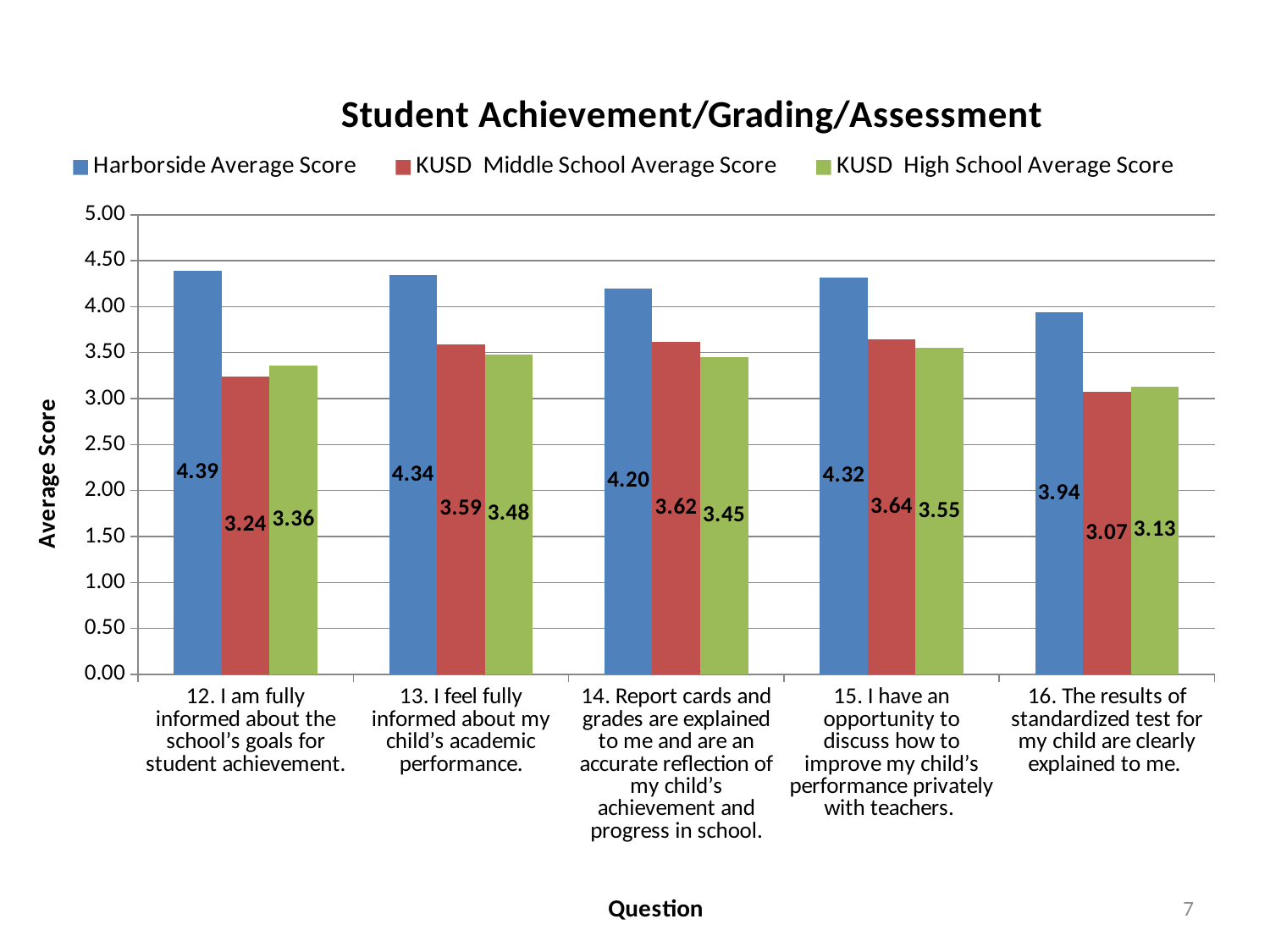
What is the title of the chart? Student Achievement/Grading/Assessment What is the KUSD Middle School Average Score for question 16 (The results of standardized test for my child are clearly explained to me)? 3.07 How many questions (categories) are shown on the x axis? 5 What is the difference between the Harborside Average Score and the KUSD Middle School Average Score for question 12? 1.15 What kind of chart is shown on the slide? Bar chart How many series does the legend list? 3 Which question has the highest Harborside Average Score? 12. I am fully informed about the school's goals for student achievement. For question 15, which is larger: the KUSD Middle School Average Score or the KUSD High School Average Score? KUSD Middle School Average Score Which question has the lowest KUSD Middle School Average Score? 16. The results of standardized test for my child are clearly explained to me. What is the KUSD High School Average Score for question 14 (Report cards and grades are explained to me)? 3.45 Is the Harborside Average Score for question 16 greater or less than 4.00? less What is the Harborside Average Score for question 12 (I am fully informed about the school's goals for student achievement)? 4.39